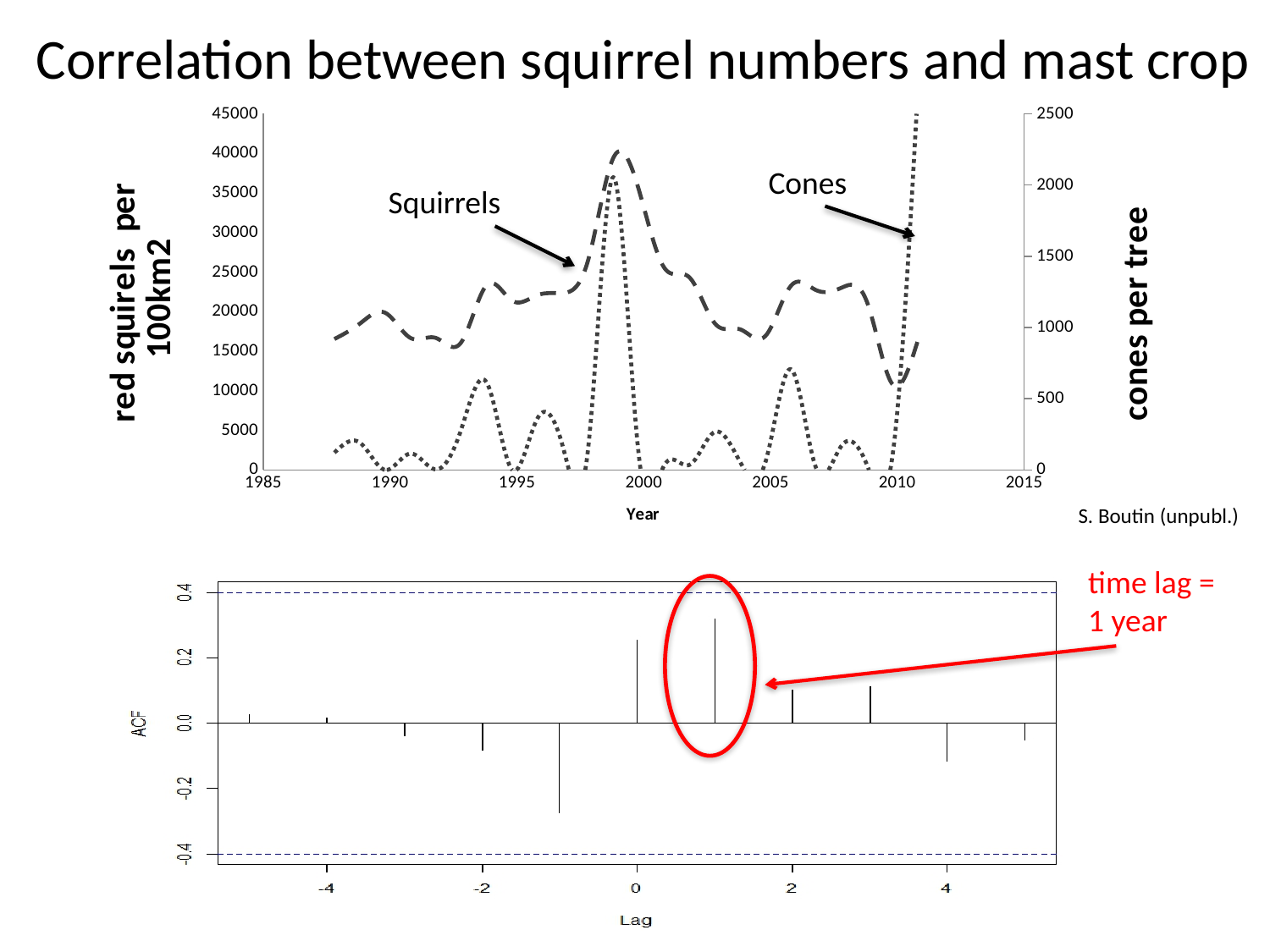
On the bottom chart, at which lag is the ACF value highest? 1 On the top chart, is the Squirrels value in 1988 greater or less than 20000? less On the bottom chart, at which lag is the ACF value lowest? -1 On the top chart, is the Cones value at its 1999 peak greater or less than 1500 cones per tree? greater What kind of chart is the bottom chart of ACF against Lag? bar chart On the bottom chart, is the ACF value at lag 1 greater or less than 0.2? greater How many series are plotted on the top chart? 2 What kind of chart is the top chart showing squirrel numbers and cones over time? line chart On the top chart, what is the label of the right-hand vertical axis? cones per tree On the bottom chart, which has the larger ACF value, lag 0 or lag 1? lag 1